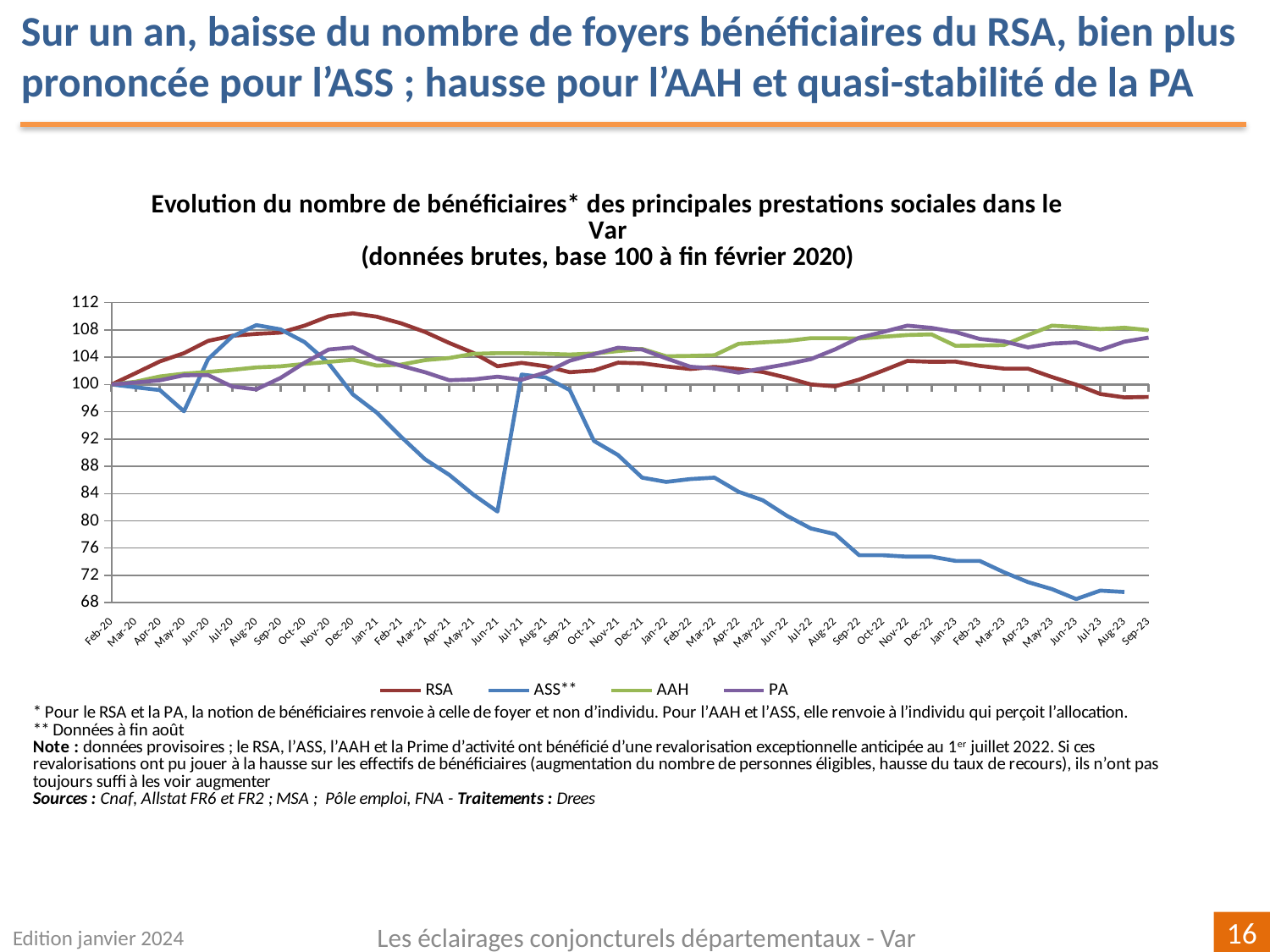
How many series does the legend list? 4 Does the ASS** series rise or fall between Jul-21 and Sep-23? fall Which series are listed in the legend? RSA, ASS**, AAH, PA Which series has the highest value at Dec-20? RSA At Sep-23, which is higher, AAH or RSA? AAH Is the value for RSA at Sep-23 greater or less than 100? less What kind of chart is shown on the slide? line chart Is the value for RSA at Dec-20 greater or less than 108? greater What is the value of all four series at Feb-20? 100 Is the value for PA at Sep-23 greater or less than 104? greater Which series has the lowest value at Sep-23? RSA